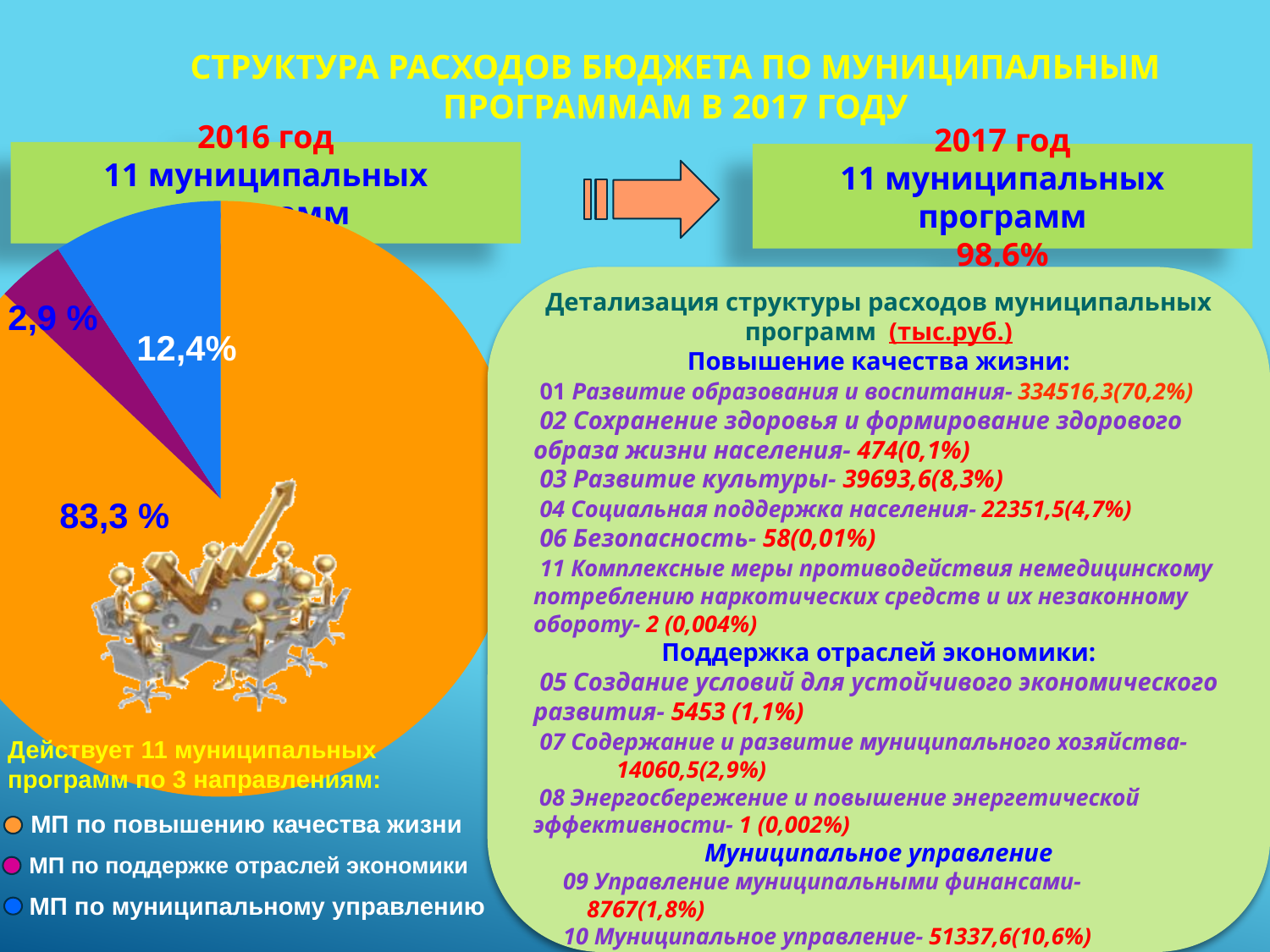
What share of the pie does the orange slice (МП по повышению качества жизни) represent? 83,3 % Which category has the smallest slice of the pie chart? МП по поддержке отраслей экономики How many slices does the pie chart have? 3 Which category has the largest slice of the pie chart? МП по повышению качества жизни What is the difference in percentage points between the orange slice (83,3 %) and the blue slice (12,4%)? 70,9 What share of the pie does the purple slice (МП по поддержке отраслей экономики) represent? 2,9 % What kind of chart is shown on the left of the slide? pie chart What share of the pie does the blue slice (МП по муниципальному управлению) represent? 12,4% How many entries does the pie chart legend list? 3 Which colour represents МП по поддержке отраслей экономики in the pie chart legend? purple Which slice is larger: МП по муниципальному управлению or МП по поддержке отраслей экономики? МП по муниципальному управлению What is the difference in percentage points between the blue slice (12,4%) and the purple slice (2,9 %)? 9,5